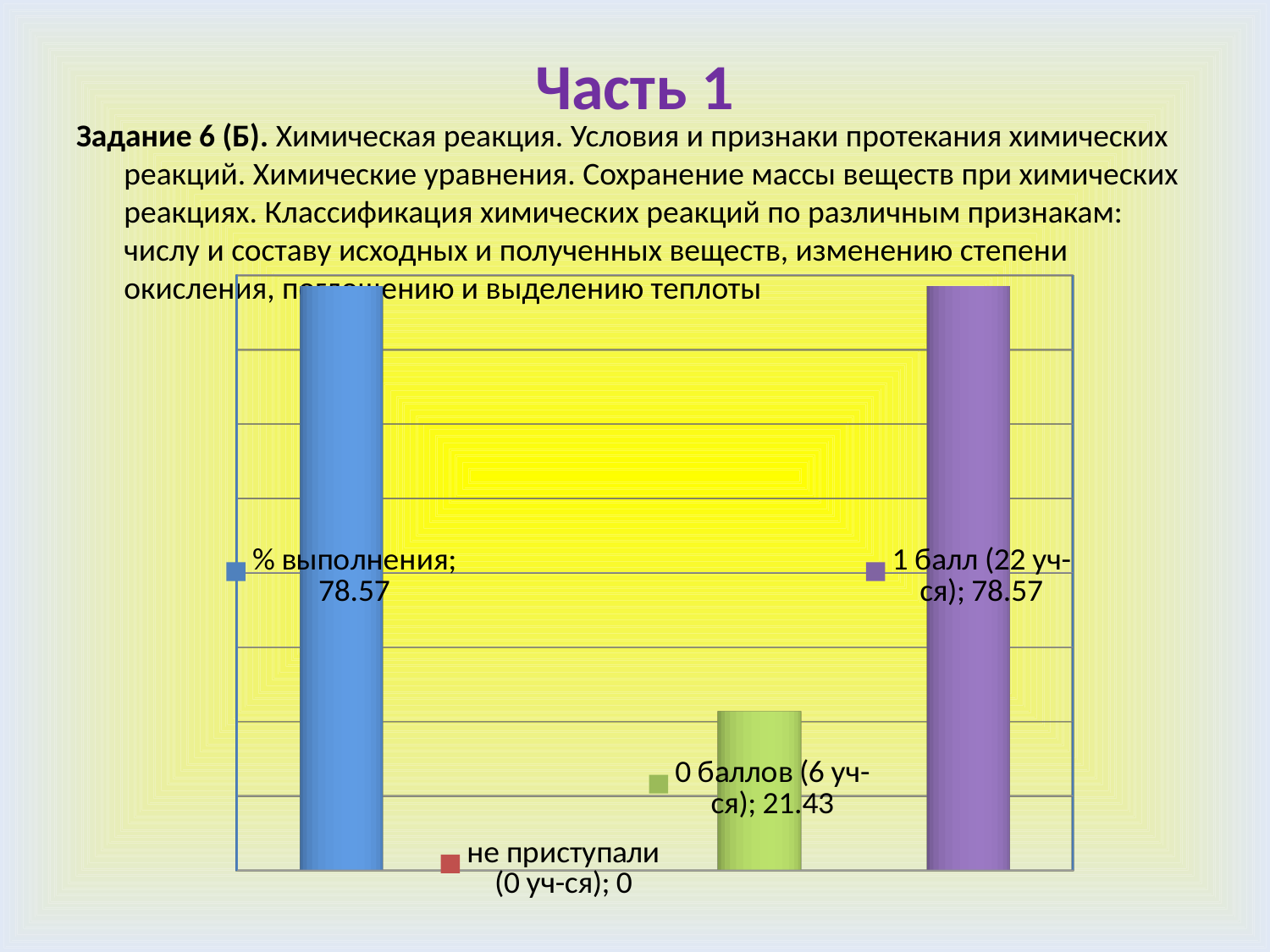
What colour is the bar for "% выполнения"? blue How many bars (categories) does the chart show? 4 How many students scored 0 points according to the label "0 баллов"? 6 Which is larger: the value for "0 баллов (6 уч-ся)" or the value for "1 балл (22 уч-ся)"? 1 балл (22 уч-ся) What colour is the bar for "1 балл (22 уч-ся)"? purple What is the value labelled for "% выполнения"? 78.57 What is the difference between the values for "1 балл (22 уч-ся)" and "0 баллов (6 уч-ся)"? 57.14 What is the value labelled for "не приступали (0 уч-ся)"? 0 What is the value labelled for "0 баллов (6 уч-ся)"? 21.43 What kind of chart is shown on the slide? bar chart What is the value labelled for "1 балл (22 уч-ся)"? 78.57 Which category has the lowest value? не приступали (0 уч-ся)